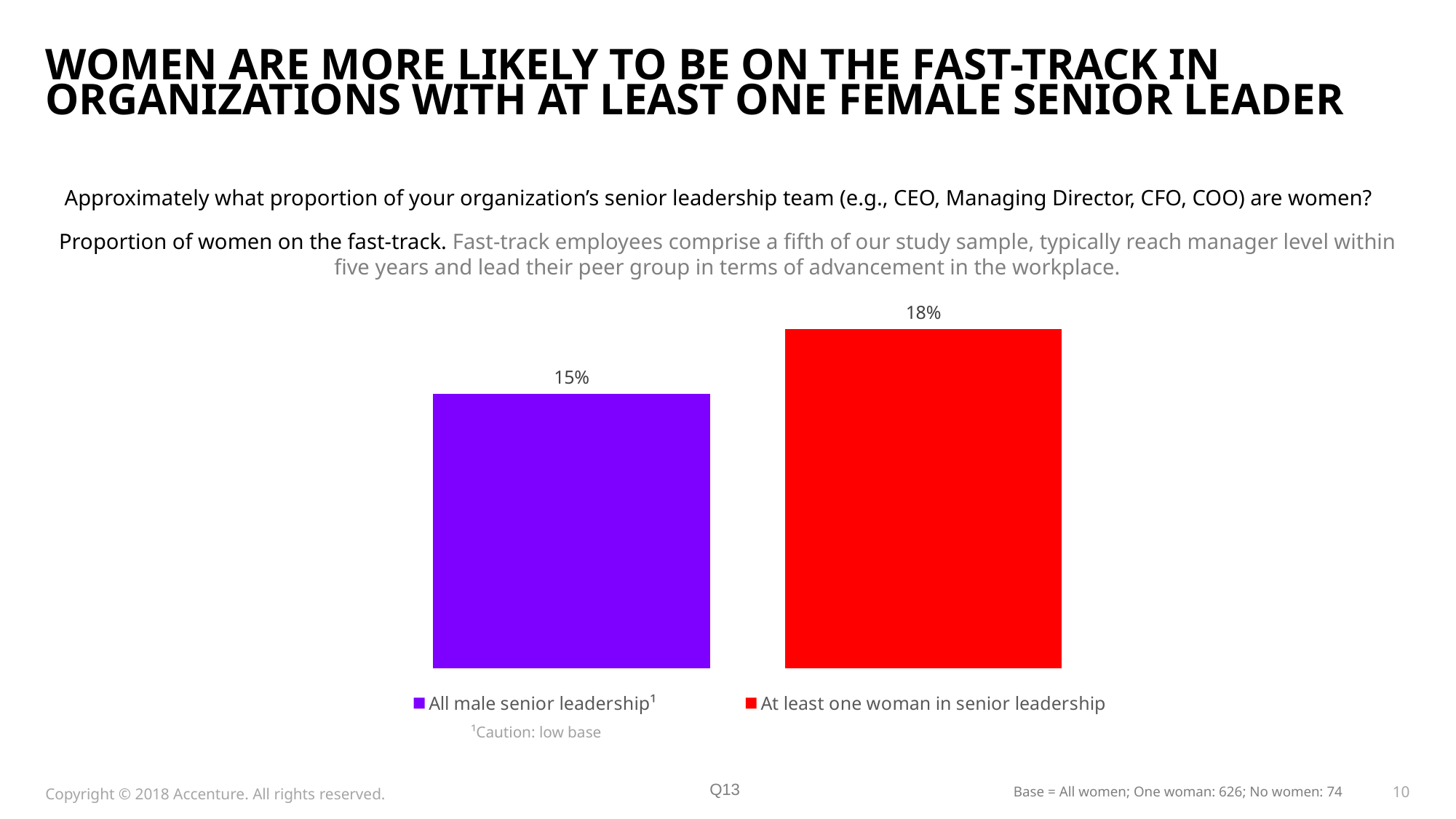
What is the proportion of women on the fast-track for organizations with all male senior leadership? 15% What colour is the bar for 'All male senior leadership'? Purple Is the value for 'At least one woman in senior leadership' larger or smaller than the value for 'All male senior leadership'? larger How many entries does the legend list? 2 What kind of chart is shown on the slide? Bar chart What is the proportion of women on the fast-track for organizations with at least one woman in senior leadership? 18% Which group has the higher proportion of women on the fast-track? At least one woman in senior leadership What is the difference in percentage points between the two bars? 3 percentage points Which group has the lower proportion of women on the fast-track? All male senior leadership Which legend entry carries the footnote 'Caution: low base'? All male senior leadership How many bars are plotted on the chart? 2